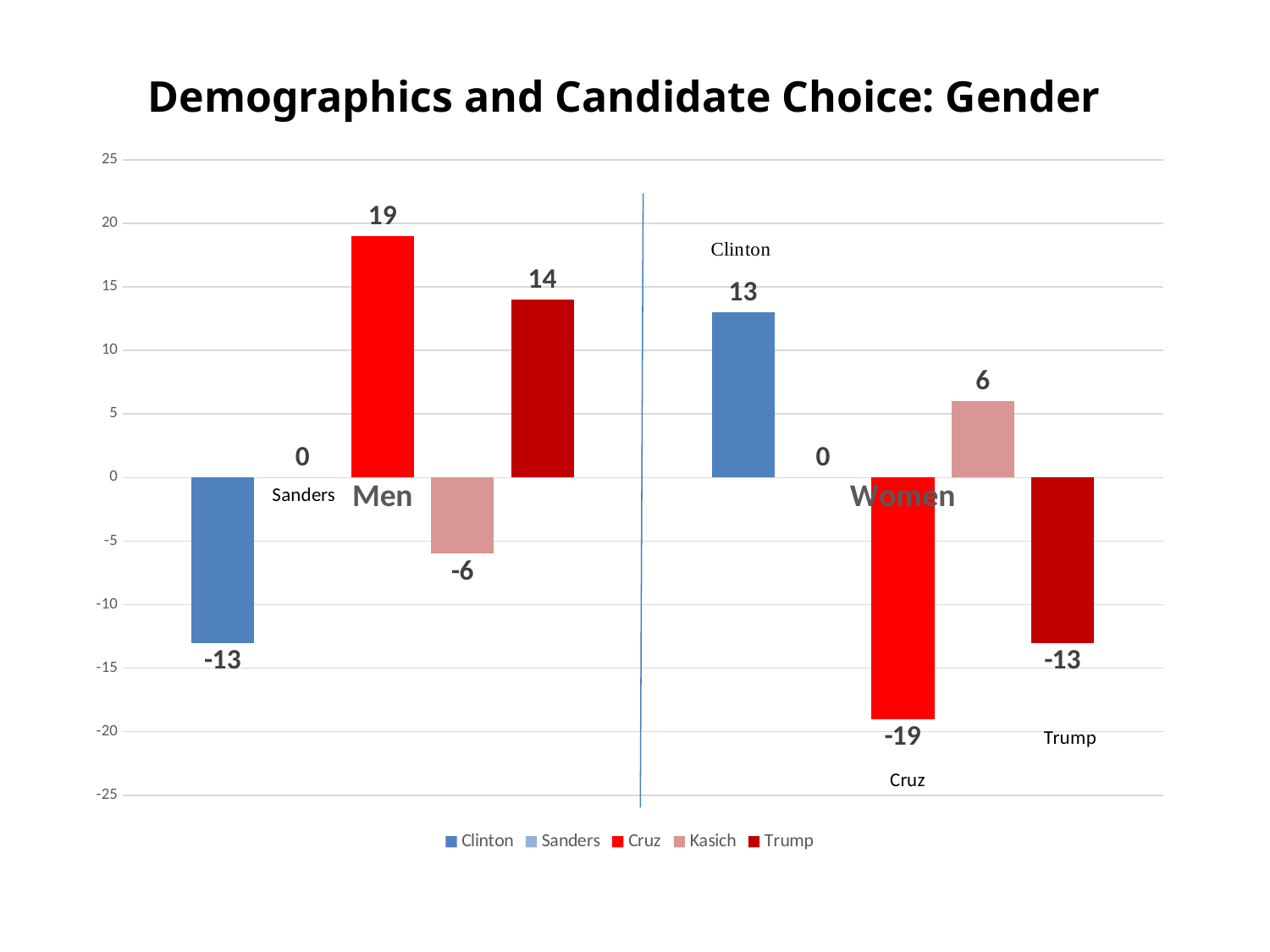
What is the value for Cruz among Men? 19 What is the difference between the Cruz value for Men and the Trump value for Men? 5 How many series does the legend list? 5 What is the value for Sanders among Men? 0 Which candidate has the highest value among Men? Cruz What is the value for Clinton among Women? 13 What is the value for Trump among Women? -13 What kind of chart is shown on the slide? Bar chart What is the title of the chart? Demographics and Candidate Choice: Gender Which candidate has the lowest value among Women? Cruz Which is larger, the Kasich value for Women or the Clinton value for Women? Clinton What is the value for Kasich among Men? -6